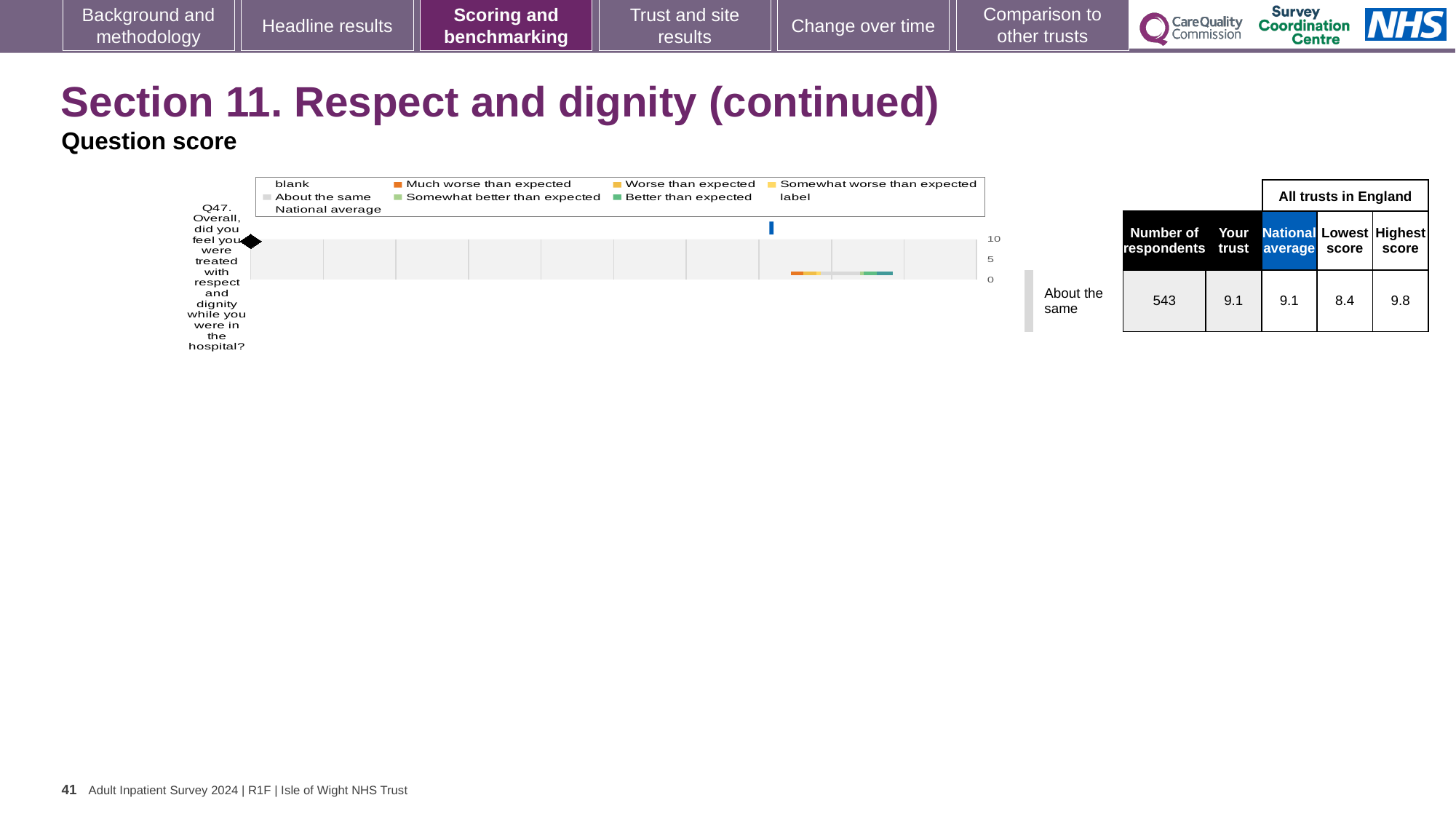
What is the lowest score among all trusts in England shown for Q47? 8.4 What is the highest score among all trusts in England shown for Q47? 9.8 What is the 'Your trust' score shown for Q47? 9.1 What is the national average score shown for Q47? 9.1 What is the highest value shown on the chart's numeric axis? 10 What is the number of respondents shown for Q47? 543 What is the difference between the highest score and the lowest score shown for Q47? 1.4 Is the 'Your trust' score for Q47 larger than, smaller than, or equal to the national average? equal What benchmark category is shown for Q47 next to the chart? About the same How many questions (categories) are plotted on the chart? 1 Which question is plotted on the chart? Q47. Overall, did you feel you were treated with respect and dignity while you were in the hospital? Is the 'Your trust' score for Q47 greater or less than 5? greater